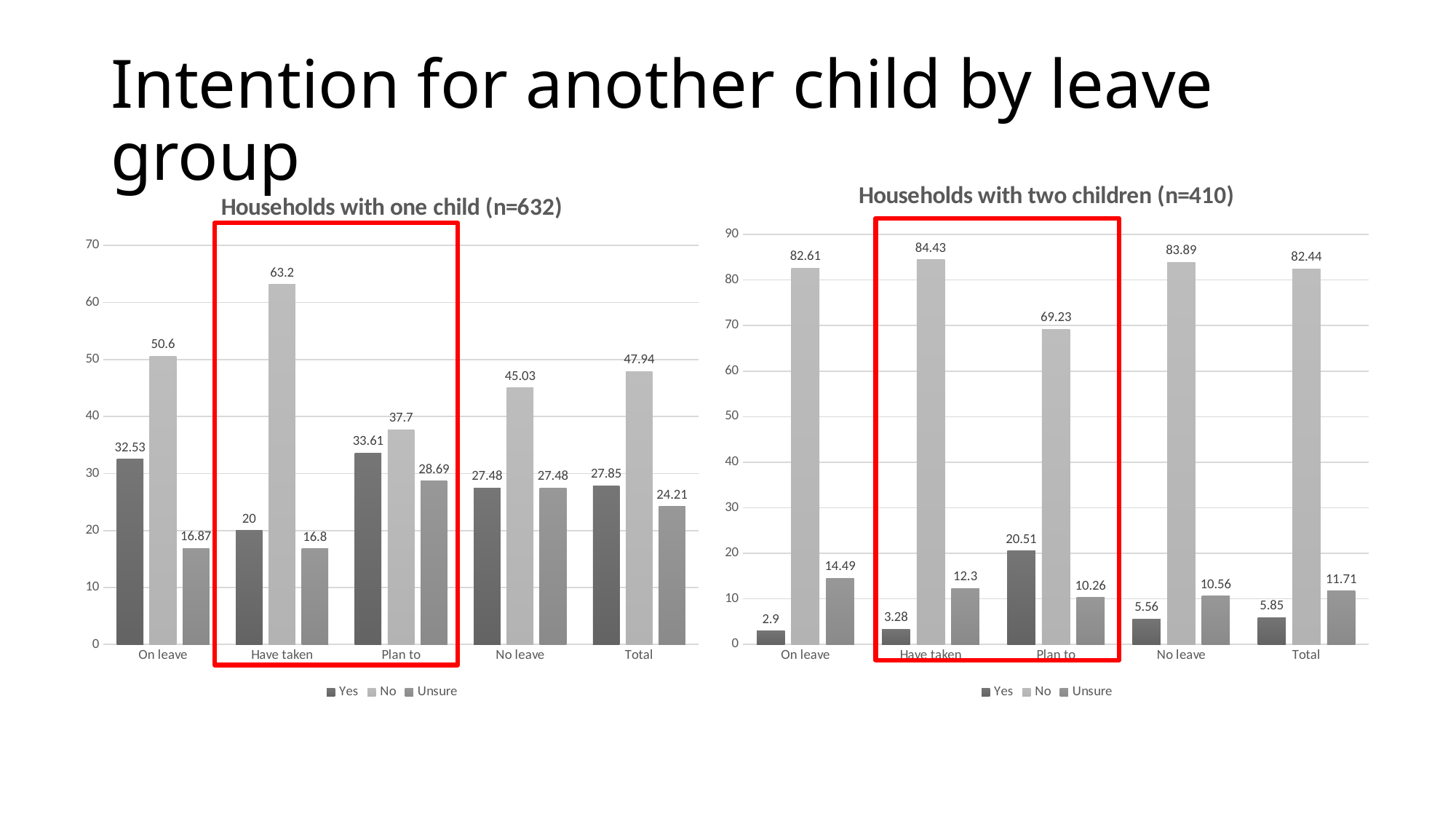
In the 'Households with one child (n=632)' chart, what is the difference between the 'No' value for 'On leave' and the 'No' value for 'Plan to'? 12.9 How many series does the legend of the 'Households with two children (n=410)' chart list? 3 In the 'Households with one child (n=632)' chart, what is the 'No' value for 'Have taken'? 63.2 What kind of chart is the 'Households with one child (n=632)' chart? Bar chart In the 'Households with one child (n=632)' chart, what is the 'Unsure' value for 'Total'? 24.21 In the 'Households with two children (n=410)' chart, is the 'No' value for 'Plan to' greater or less than 70? less In the 'Households with two children (n=410)' chart, which category has the lowest 'Yes' value? On leave In the 'Households with one child (n=632)' chart, which category has the highest 'Yes' value? Plan to In the 'Households with two children (n=410)' chart, what is the 'Yes' value for 'Plan to'? 20.51 In the 'Households with two children (n=410)' chart, which is larger: the 'Unsure' value for 'On leave' or the 'Unsure' value for 'Total'? On leave How many categories are shown on the x axis of the 'Households with one child (n=632)' chart? 5 What are the legend entries of the 'Households with one child (n=632)' chart? Yes, No, Unsure